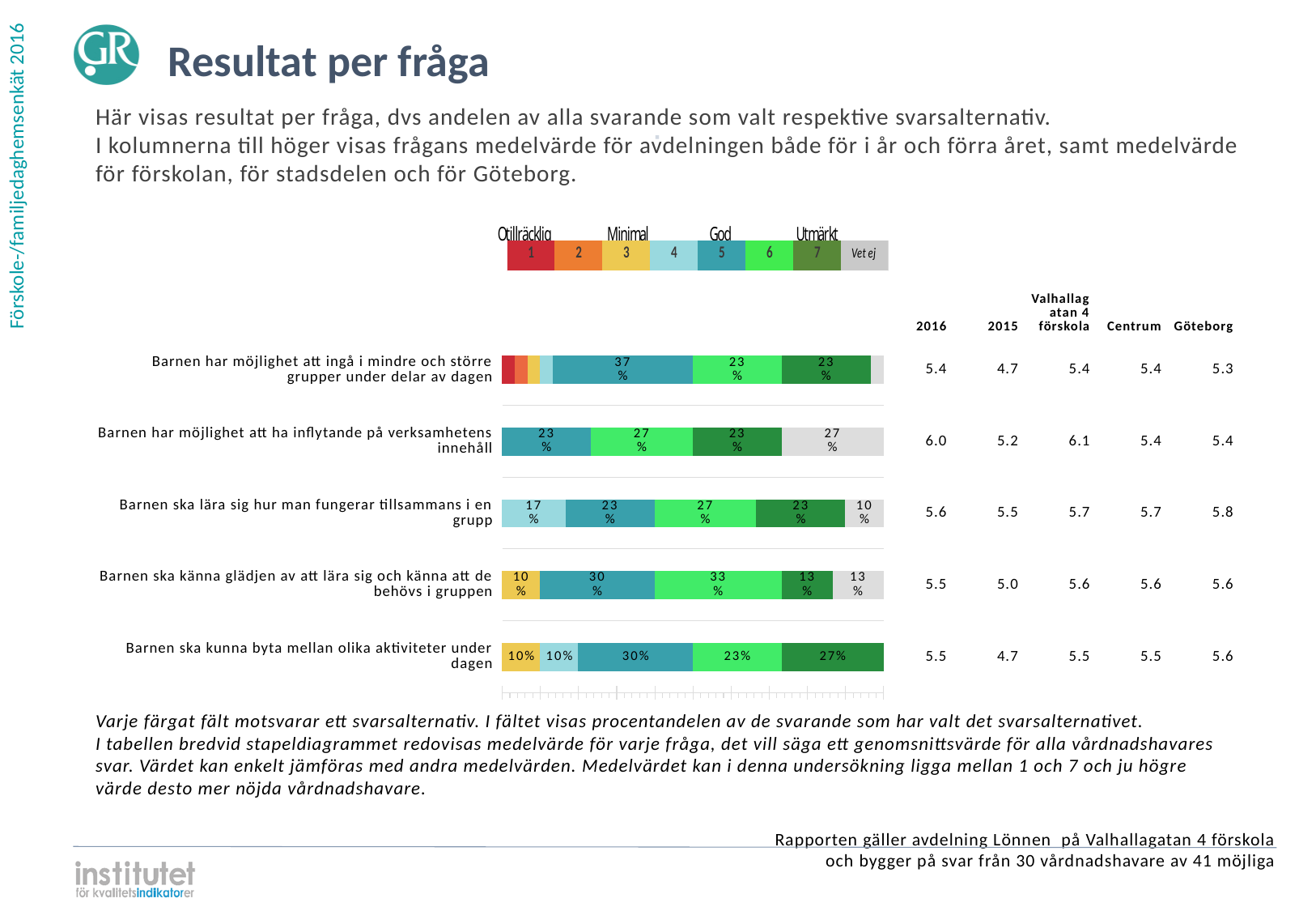
What is the difference between the alternative 5 share and the alternative 7 share for 'Barnen ska kunna byta mellan olika aktiviteter under dagen'? 3% How many answer alternatives does the legend above the chart list? 8 What percentage chose alternative 6 for 'Barnen ska känna glädjen av att lära sig och känna att de behövs i gruppen'? 33% Which colour represents the 'Vet ej' answer alternative in the legend? Grey What percentage chose alternative 4 for 'Barnen ska lära sig hur man fungerar tillsammans i en grupp'? 17% What percentage chose alternative 7 (Utmärkt) for 'Barnen ska kunna byta mellan olika aktiviteter under dagen'? 27% How many questions (categories) are plotted in the bar chart? 5 What kind of chart is shown on the slide? Stacked bar chart What percentage chose 'Vet ej' for 'Barnen har möjlighet att ha inflytande på verksamhetens innehåll'? 27% What percentage of respondents chose alternative 5 (God) for 'Barnen har möjlighet att ingå i mindre och större grupper under delar av dagen'? 37% Which is larger for 'Barnen ska känna glädjen av att lära sig och känna att de behövs i gruppen': the share for alternative 5 or the share for alternative 7? Alternative 5 What is the total of the labelled segments in the bar for 'Barnen ska kunna byta mellan olika aktiviteter under dagen'? 100%